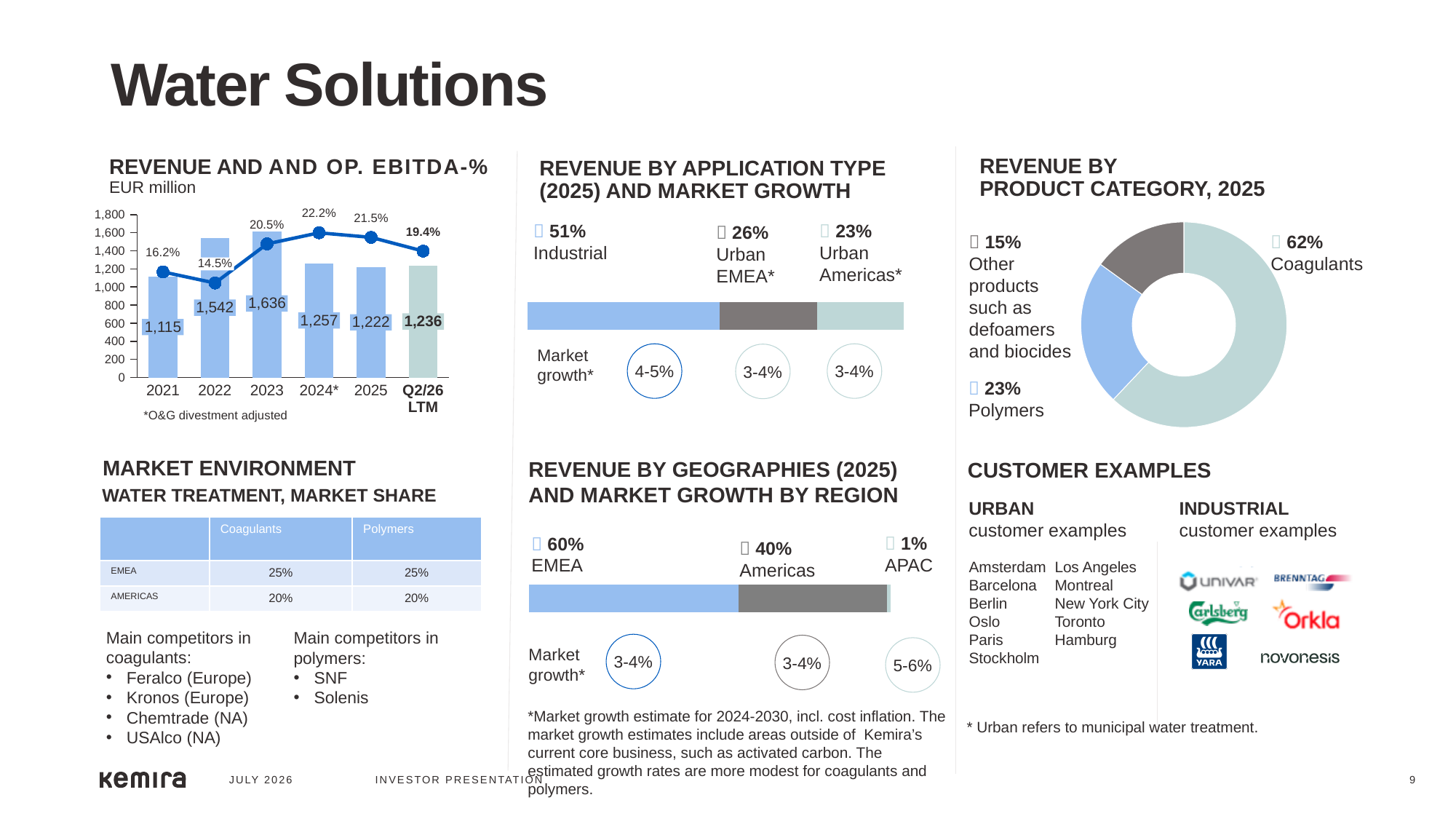
In the 'Revenue and Op. EBITDA-%' chart, which year has the highest revenue? 2023 In the 'Revenue by product category, 2025' donut chart, what share do Coagulants have? 62% In the 'Revenue and Op. EBITDA-%' chart, what was the Op. EBITDA-% in 2024*? 22.2% In the 'Revenue and Op. EBITDA-%' chart, what was revenue in 2023? 1,636 In the 'Revenue and Op. EBITDA-%' chart, is revenue higher in 2024* or in 2025? 2024* How many periods are shown on the x axis of the 'Revenue and Op. EBITDA-%' chart? 6 In the 'Revenue by product category, 2025' donut chart, which category has the smallest share? Other products such as defoamers and biocides In the 'Revenue and Op. EBITDA-%' chart, which year has the lowest Op. EBITDA-%? 2022 In the 'Revenue and Op. EBITDA-%' chart, what is the difference in revenue between 2022 and 2021? 427 In the 'Revenue by application type (2025)' bar, what share of revenue comes from Industrial? 51% In the 'Revenue by geographies (2025)' bar, what is the market growth shown for APAC? 5-6% What type of chart is 'Revenue by product category, 2025'? Donut (pie) chart